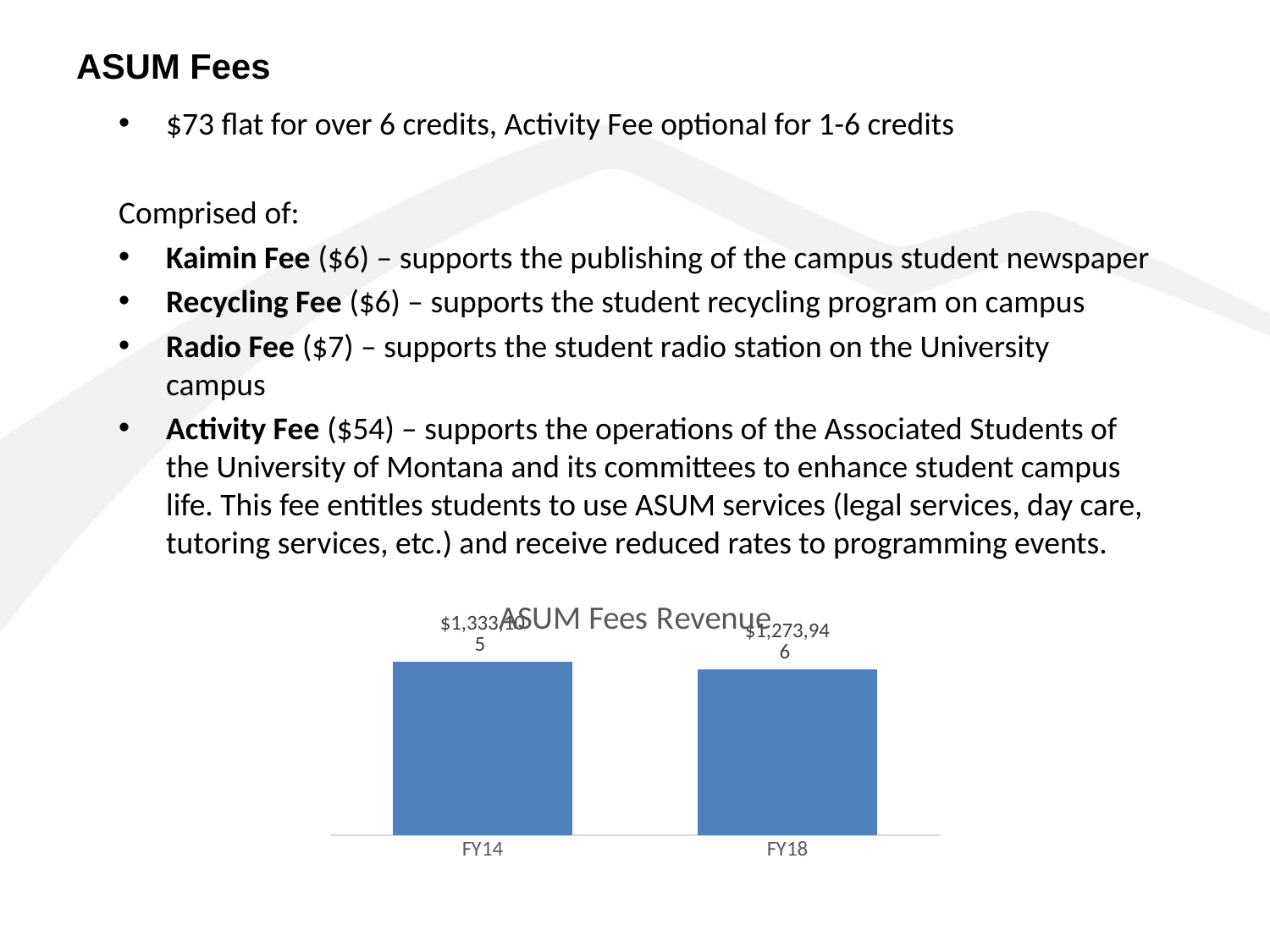
Is the ASUM Fees Revenue larger for FY14 or FY18? FY14 Which fiscal year has the highest ASUM Fees Revenue? FY14 What kind of chart is shown on the slide? bar chart What is the title of the chart on the slide? ASUM Fees Revenue What is the ASUM Fees Revenue value for FY18? $1,273,946 How many categories are plotted in the ASUM Fees Revenue chart? 2 What are the category labels on the x axis of the ASUM Fees Revenue chart? FY14 and FY18 Which fiscal year has the lowest ASUM Fees Revenue? FY18 Does ASUM Fees Revenue rise or fall from FY14 to FY18? fall